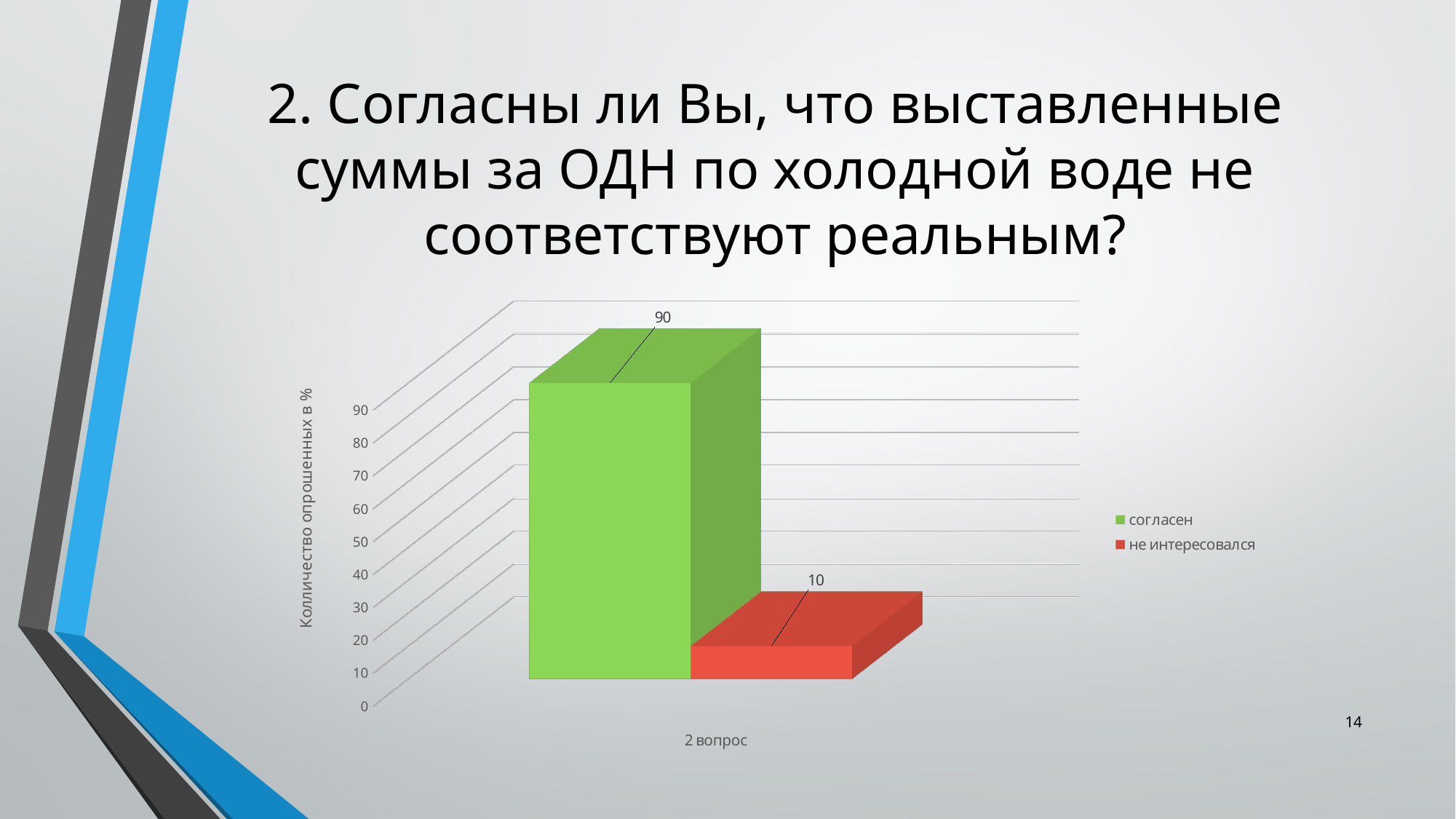
What kind of chart is shown on the slide? bar chart What is the value for "не интересовался"? 10 Which series has the highest value? согласен Which is larger, the value for "согласен" or for "не интересовался"? согласен What is the label on the vertical axis? Колличество опрошенных в % What colour is the bar for "не интересовался"? red What is the difference between the values for "согласен" and "не интересовался"? 80 Which series has the lowest value? не интересовался How many series does the legend list? 2 What is the value for "согласен"? 90 Is the value for "не интересовался" greater or less than 20? less Is the value for "согласен" greater or less than 50? greater